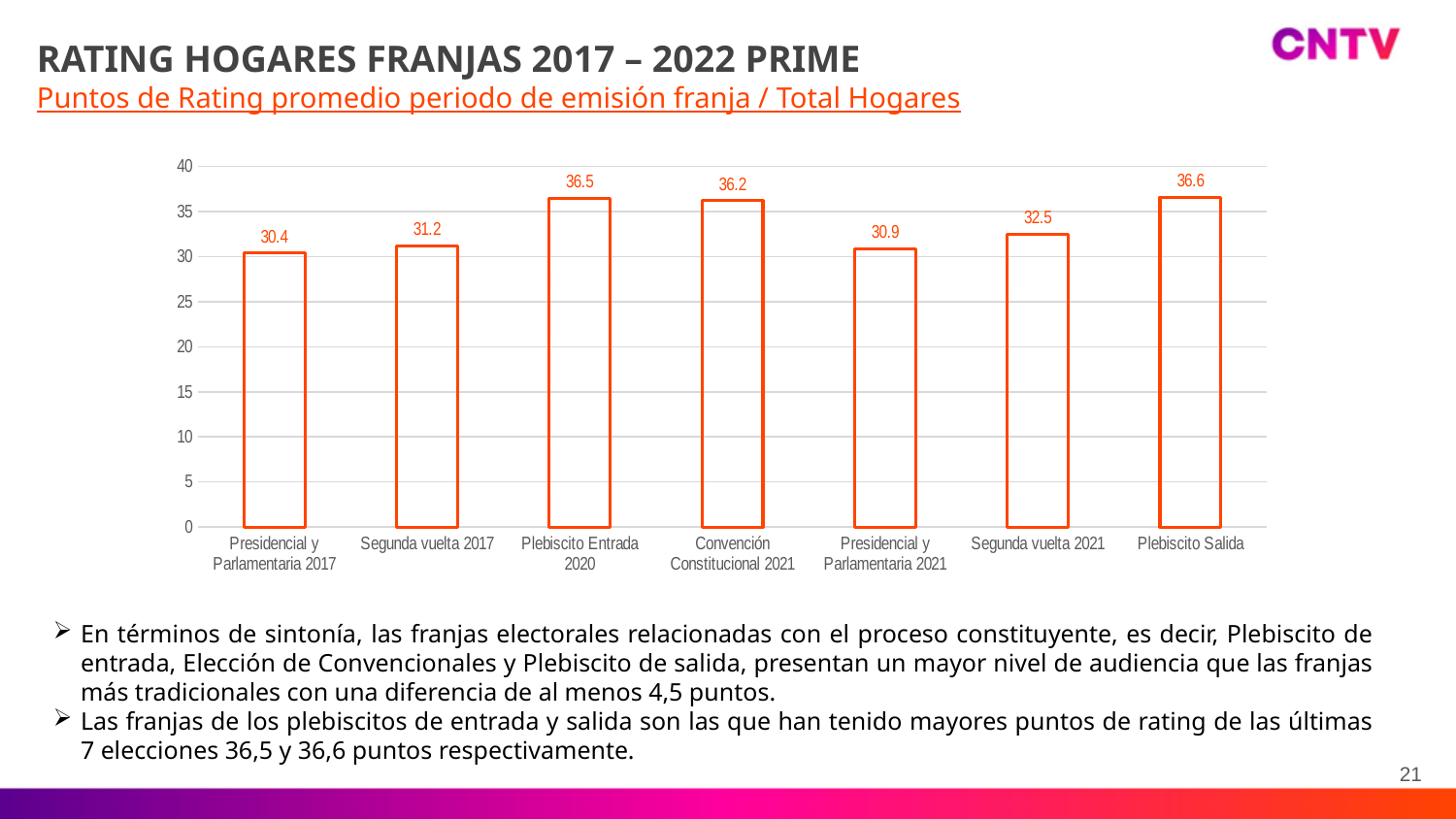
What is the rating value for Convención Constitucional 2021? 36.2 What is the difference between the rating for Plebiscito Salida and the rating for Presidencial y Parlamentaria 2021? 5.7 What is the rating value for Plebiscito Entrada 2020? 36.5 How many categories are shown on the x axis of the chart? 7 What is the rating value for Segunda vuelta 2021? 32.5 What is the difference between the rating for Segunda vuelta 2021 and the rating for Segunda vuelta 2017? 1.3 Which has a higher rating, Presidencial y Parlamentaria 2017 or Plebiscito Entrada 2020? Plebiscito Entrada 2020 What kind of chart is shown on the slide? bar chart Is the value for Presidencial y Parlamentaria 2021 greater or less than 35? less What is the rating value for Presidencial y Parlamentaria 2017? 30.4 Which has a higher rating, Convención Constitucional 2021 or Segunda vuelta 2021? Convención Constitucional 2021 What is the maximum value shown on the vertical axis of the chart? 40